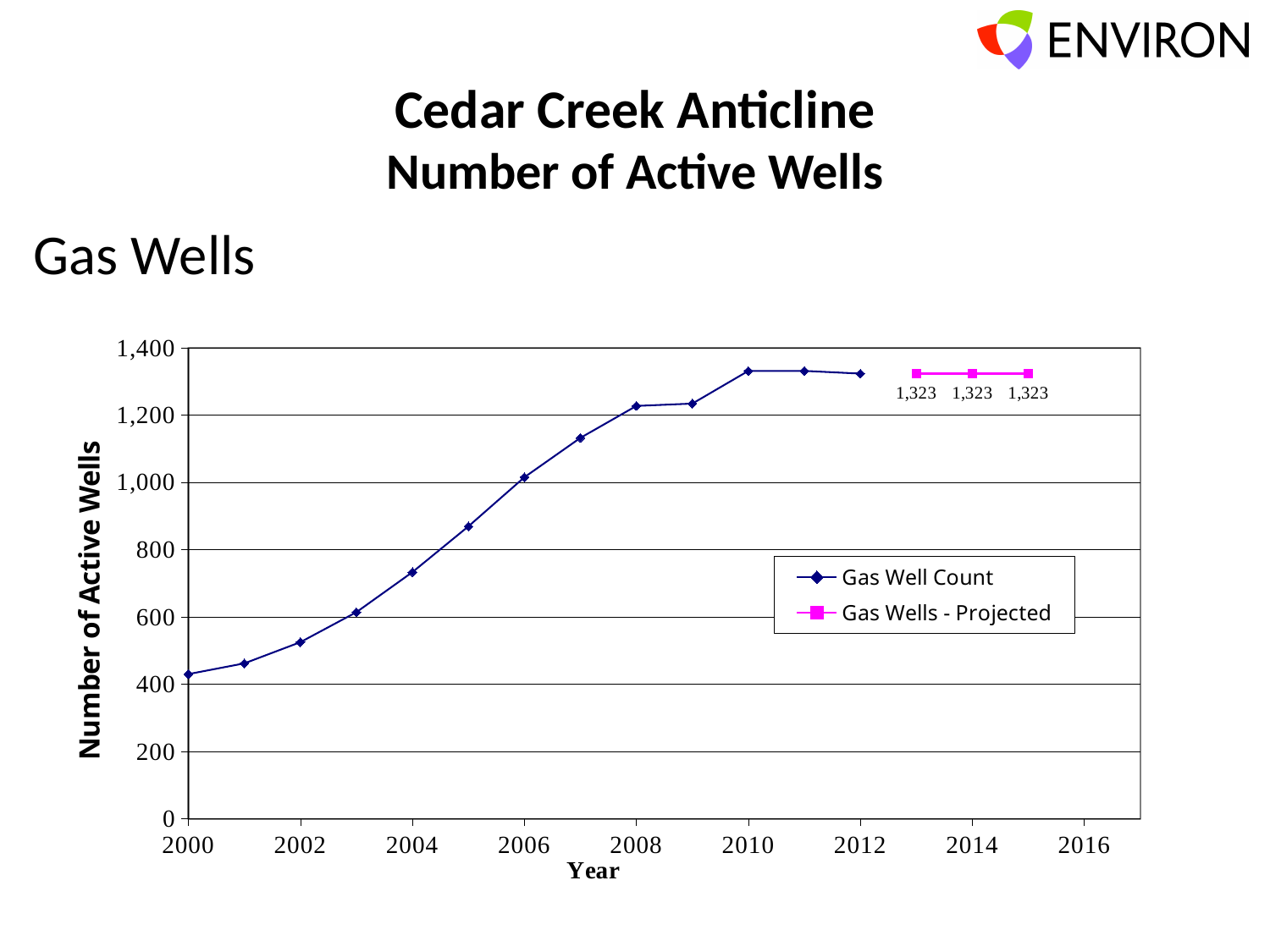
How many data points does the Gas Wells - Projected series have? 3 What is the projected number of gas wells for 2015? 1,323 What is the projected number of gas wells for 2014? 1,323 Which year has a higher Gas Well Count, 2004 or 2008? 2008 What kind of chart is shown on the slide? line chart Does the Gas Well Count rise or fall from 2000 to 2010? rise How many series does the legend list? 2 Which year has the lowest Gas Well Count? 2000 Is the Gas Well Count value for 2008 greater or less than 1,000? greater Is the Gas Well Count value for 2010 greater or less than 1,200? greater Is the Gas Well Count value for 2000 greater or less than 600? less